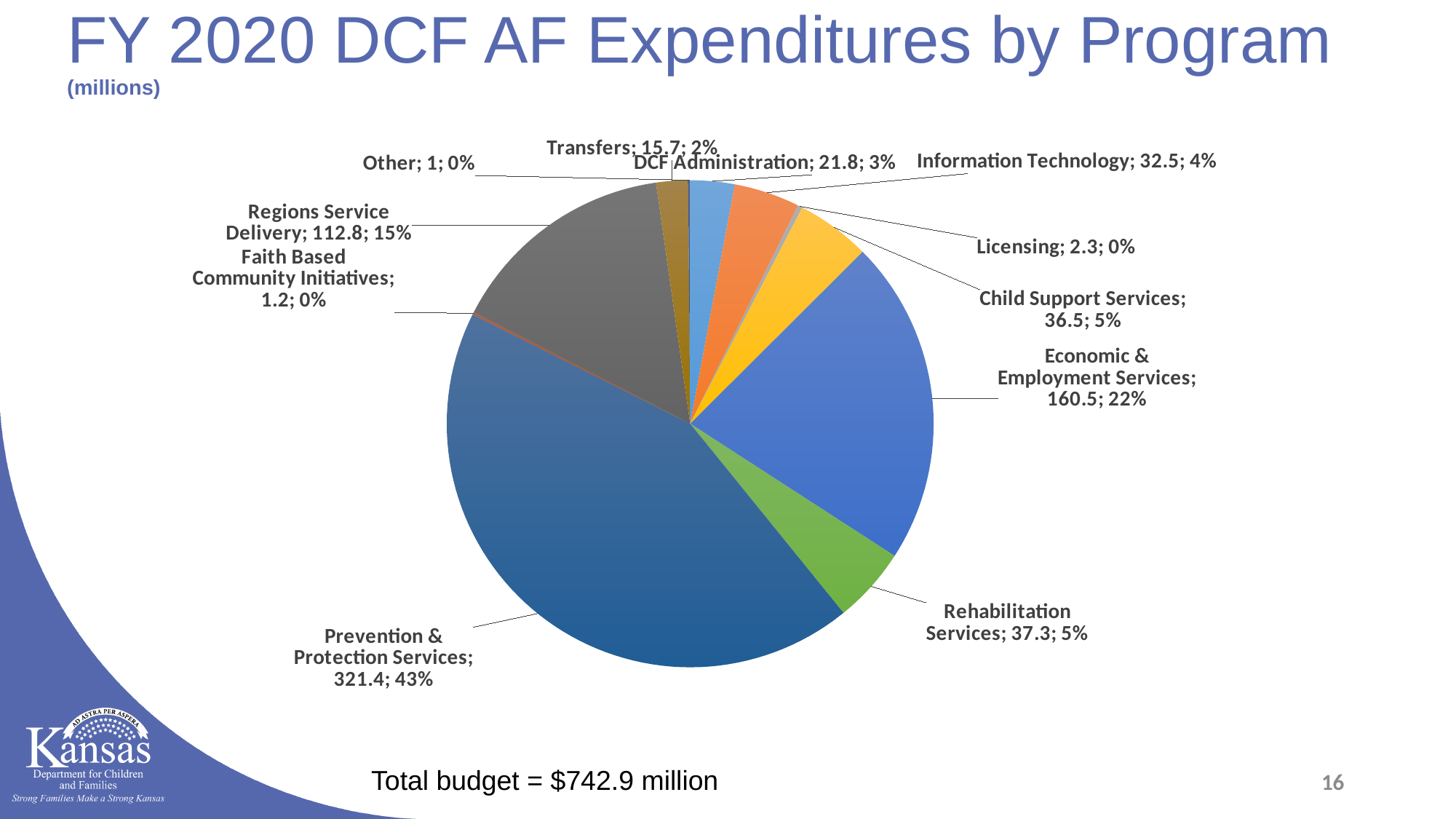
What is the value for Economic & Employment Services? 160.5 What is the difference between Rehabilitation Services and Child Support Services? 0.8 What type of chart is shown on the slide? pie chart What is the value for Prevention & Protection Services? 321.4 What is the value for Information Technology? 32.5 What share of the pie does Economic & Employment Services represent? 22% Which program has the largest expenditure? Prevention & Protection Services Which is larger, DCF Administration or Transfers? DCF Administration Which program has the smallest expenditure? Other What is the value for Regions Service Delivery? 112.8 What share of the pie does Regions Service Delivery represent? 15% How many program slices are shown in the pie chart? 11